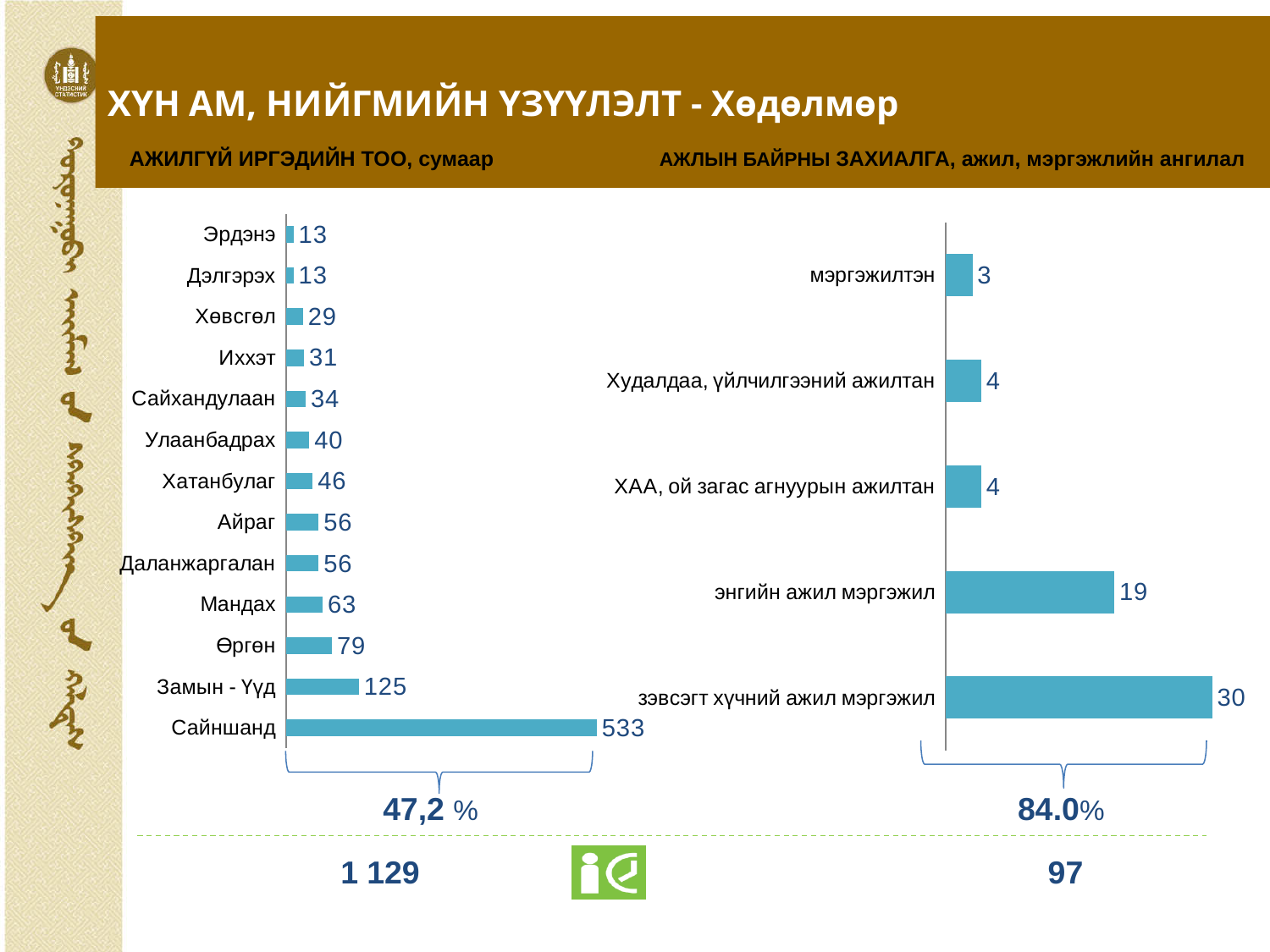
In the right chart (АЖЛЫН БАЙРНЫ ЗАХИАЛГА), what is the value for мэргэжилтэн? 3 In the left chart (АЖИЛГҮЙ ИРГЭДИЙН ТОО, сумаар), which is larger, Хатанбулаг or Улаанбадрах? Хатанбулаг In the right chart (АЖЛЫН БАЙРНЫ ЗАХИАЛГА), what is the difference between зэвсэгт хүчний ажил мэргэжил and энгийн ажил мэргэжил? 11 In the left chart (АЖИЛГҮЙ ИРГЭДИЙН ТОО, сумаар), what is the value for Сайншанд? 533 In the left chart (АЖИЛГҮЙ ИРГЭДИЙН ТОО, сумаар), how many categories are shown? 13 In the left chart (АЖИЛГҮЙ ИРГЭДИЙН ТОО, сумаар), what is the difference between Өргөн and Мандах? 16 In the right chart (АЖЛЫН БАЙРНЫ ЗАХИАЛГА), what is the value for зэвсэгт хүчний ажил мэргэжил? 30 In the left chart (АЖИЛГҮЙ ИРГЭДИЙН ТОО, сумаар), which category has the lowest value? Эрдэнэ and Дэлгэрэх (13 each) In the left chart (АЖИЛГҮЙ ИРГЭДИЙН ТОО, сумаар), what is the value for Замын - Үүд? 125 In the left chart (АЖИЛГҮЙ ИРГЭДИЙН ТОО, сумаар), which category has the highest value? Сайншанд What type of chart is the right chart (АЖЛЫН БАЙРНЫ ЗАХИАЛГА)? Bar chart In the right chart (АЖЛЫН БАЙРНЫ ЗАХИАЛГА), how many categories are shown? 5